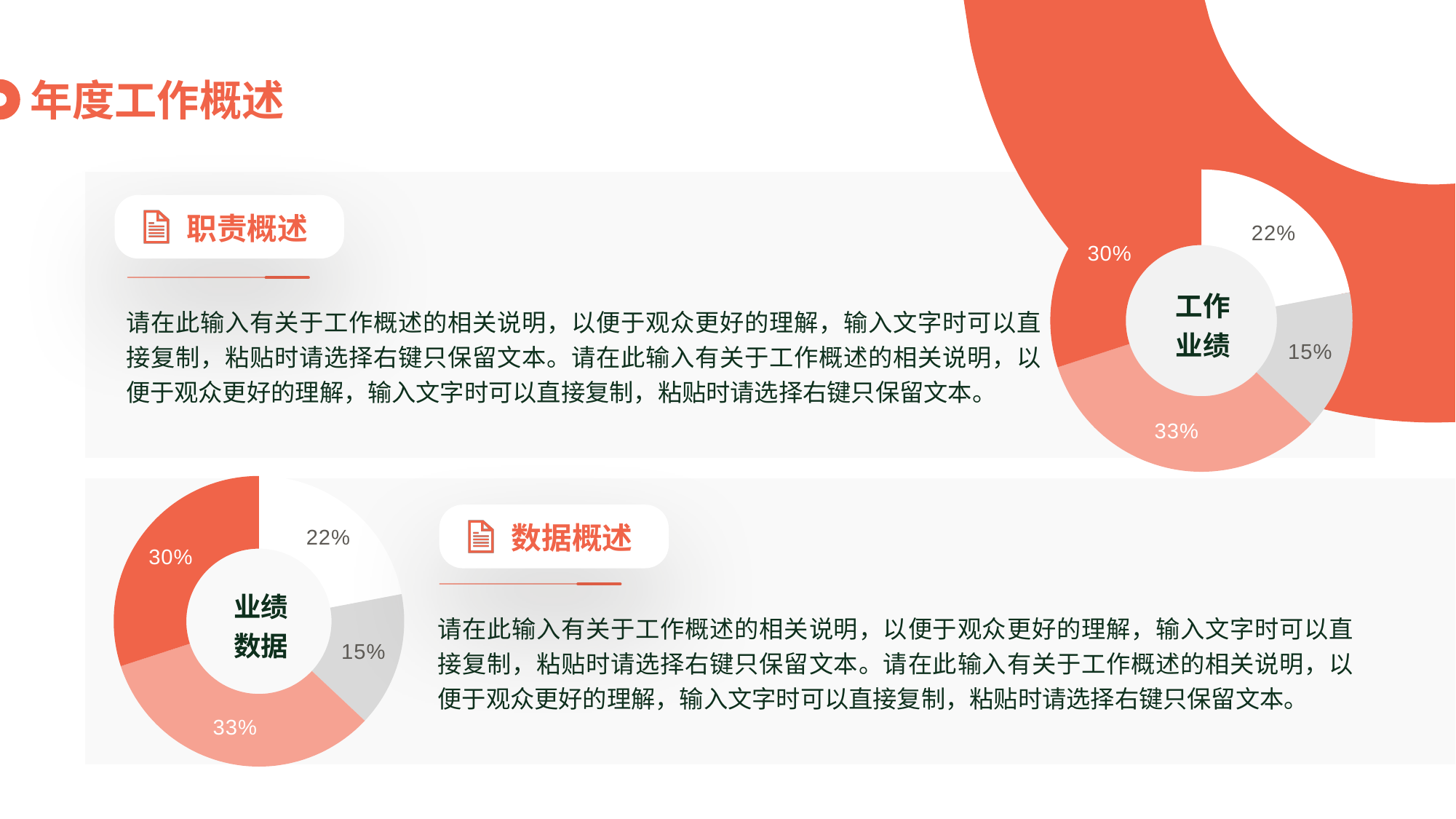
What is the smallest percentage shown on the "业绩数据" donut chart? 15% On the "工作业绩" donut chart, which is larger: the 30% slice or the 22% slice? The 30% slice What is the smallest percentage shown on the "工作业绩" donut chart? 15% What kind of chart is the "业绩数据" chart in the bottom left? Donut (pie) chart What kind of chart is the "工作业绩" chart in the top right? Donut (pie) chart How many slices does the "业绩数据" donut chart have? 4 On the "工作业绩" donut chart, what is the difference between the largest slice and the smallest slice? 18% On the "业绩数据" donut chart, what percentage is shown on the dark orange slice? 30% What text is written in the centre of the "业绩数据" donut chart? 业绩数据 How many slices does the "工作业绩" donut chart have? 4 What is the largest percentage shown on the "工作业绩" donut chart? 33% What is the largest percentage shown on the "业绩数据" donut chart? 33%